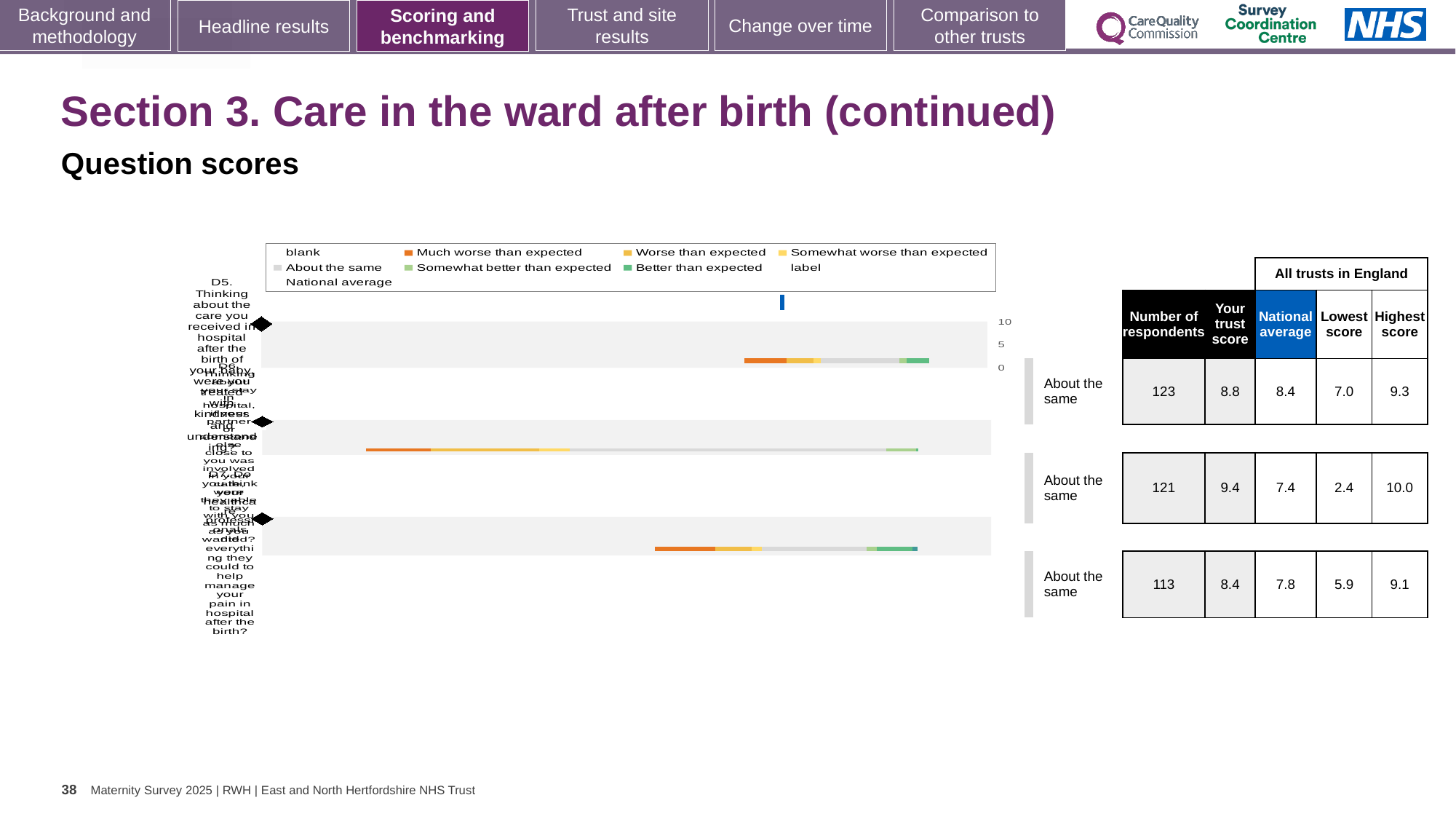
How many entries does the chart legend list? 9 Which row has the lowest number of respondents in the table? the third row (113) In the table, what is the number of respondents for the first row (D5)? 123 For the first row (D5), what is the difference between 'Your trust score' and the national average? 0.4 In the table, what is the highest score for the third row? 9.1 Which row has the highest 'Your trust score' in the table? the second row (9.4) In the table, what is 'Your trust score' for the first row (D5)? 8.8 In the table, what is the national average for the second row? 7.4 In the table, what is the lowest score for the second row? 2.4 What benchmark category label is shown for all three rows? About the same How many question rows (bars) does the chart show? 3 What kind of chart is shown on the slide? bar chart